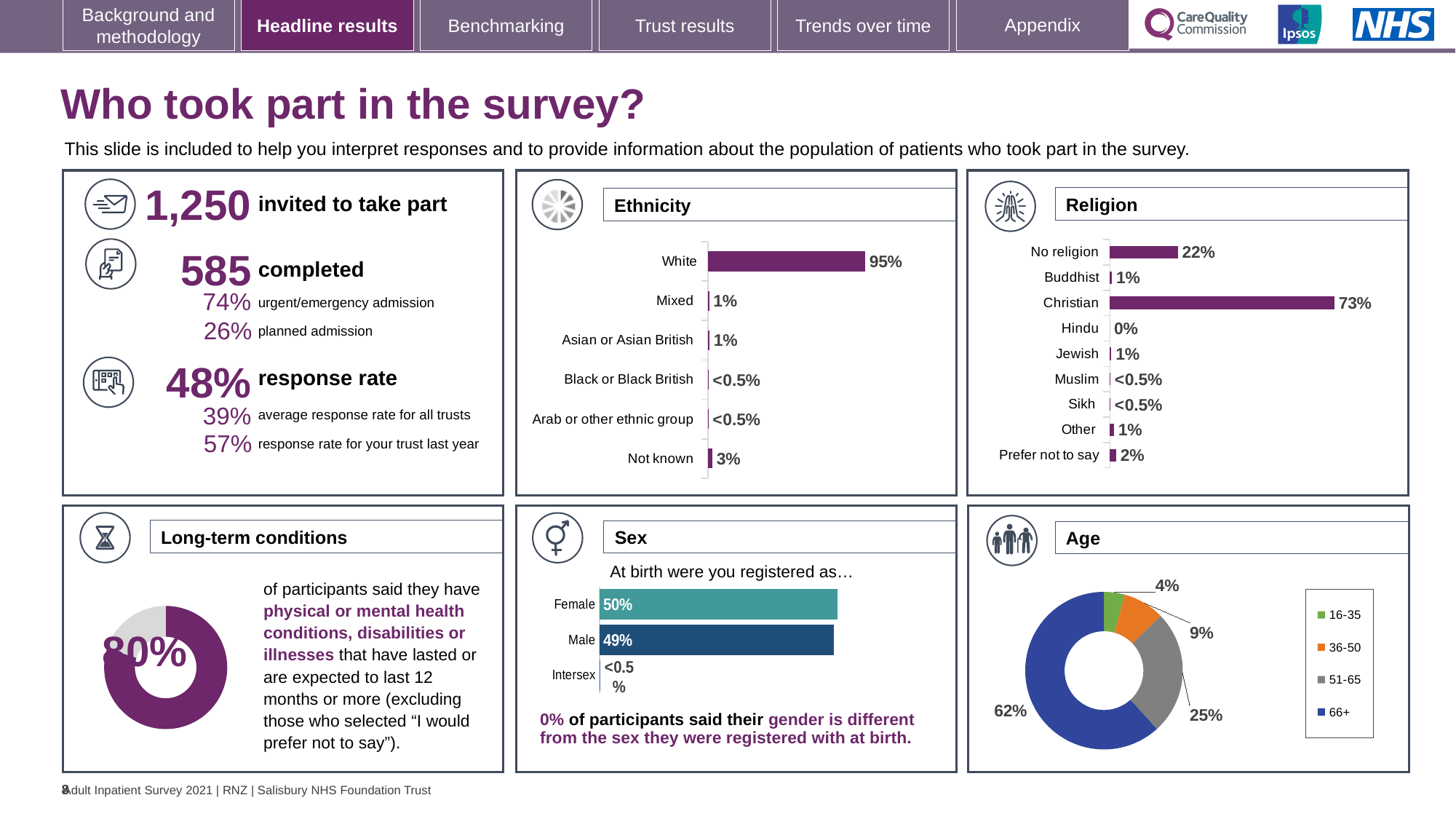
In the Religion chart, what is the difference between the values for Christian and No religion? 51 percentage points In the Ethnicity chart, how many ethnic group categories are shown? 6 In the Religion chart, which religion category has the highest value? Christian In the Religion chart, what is the value for No religion? 22% In the Age chart, what share of participants are aged 66+? 62% In the Religion chart, what is the value for Hindu? 0% In the Sex chart, which is larger, the value for Female or the value for Male? Female In the Age chart, how many age groups does the legend list? 4 In the Sex chart, what is the value for Male? 49% In the Ethnicity chart, what is the value for Not known? 3% What kind of chart is the Age chart? Doughnut chart In the Ethnicity chart, what is the value for White? 95%